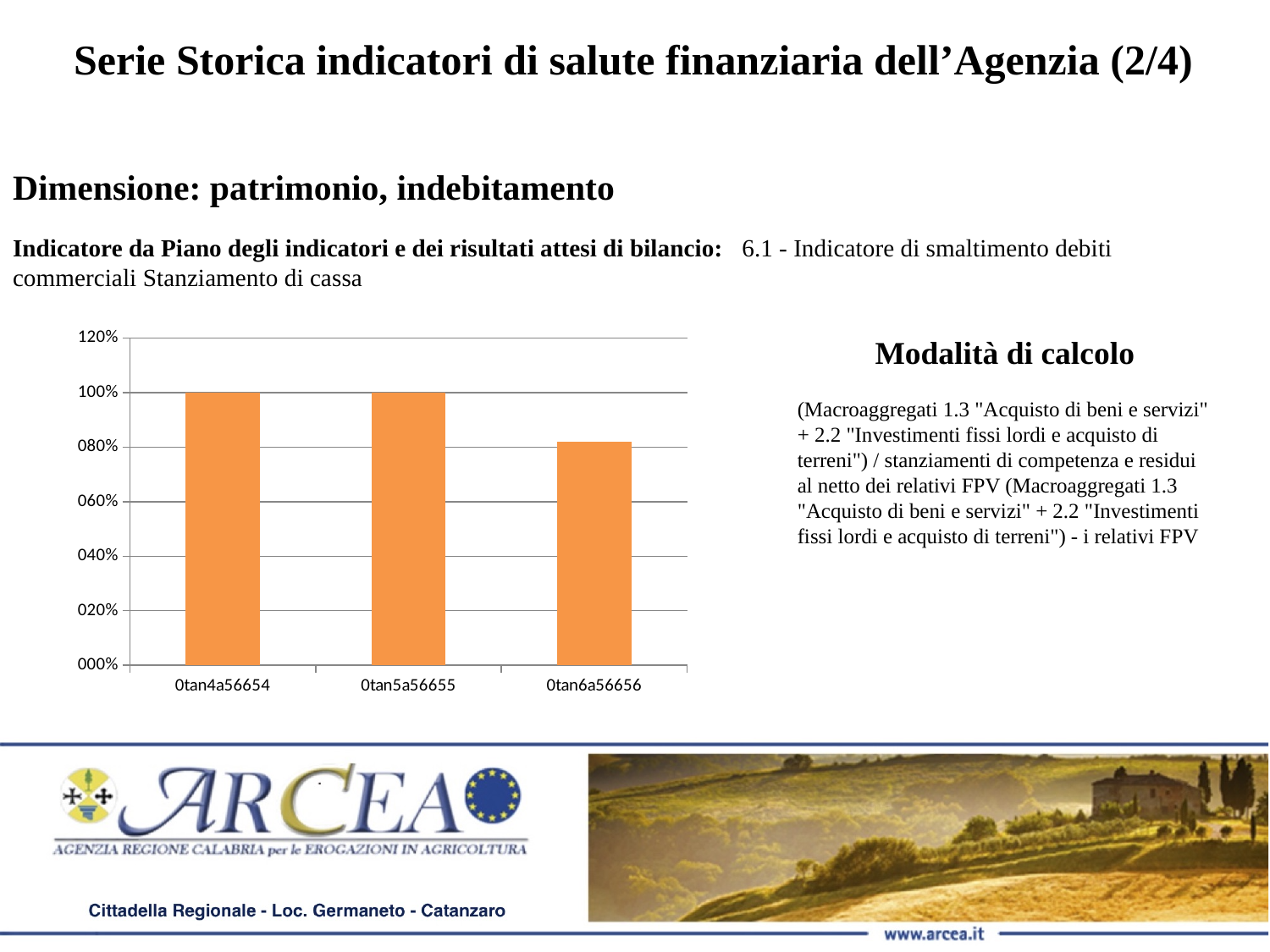
What is the highest tick value shown on the y axis? 120% Is the value for 0tan6a56656 greater or less than 100%? less What kind of chart is shown on the slide? bar chart Which is larger, the value for 0tan4a56654 or the value for 0tan6a56656? 0tan4a56654 What is the value for 0tan4a56654? 100% Which category has the lowest value? 0tan6a56656 Which is larger, the value for 0tan5a56655 or the value for 0tan6a56656? 0tan5a56655 What is the value for 0tan5a56655? 100% How many categories are shown on the x axis? 3 What colour are the bars in the chart? orange Do the values rise or fall from 0tan5a56655 to 0tan6a56656? fall